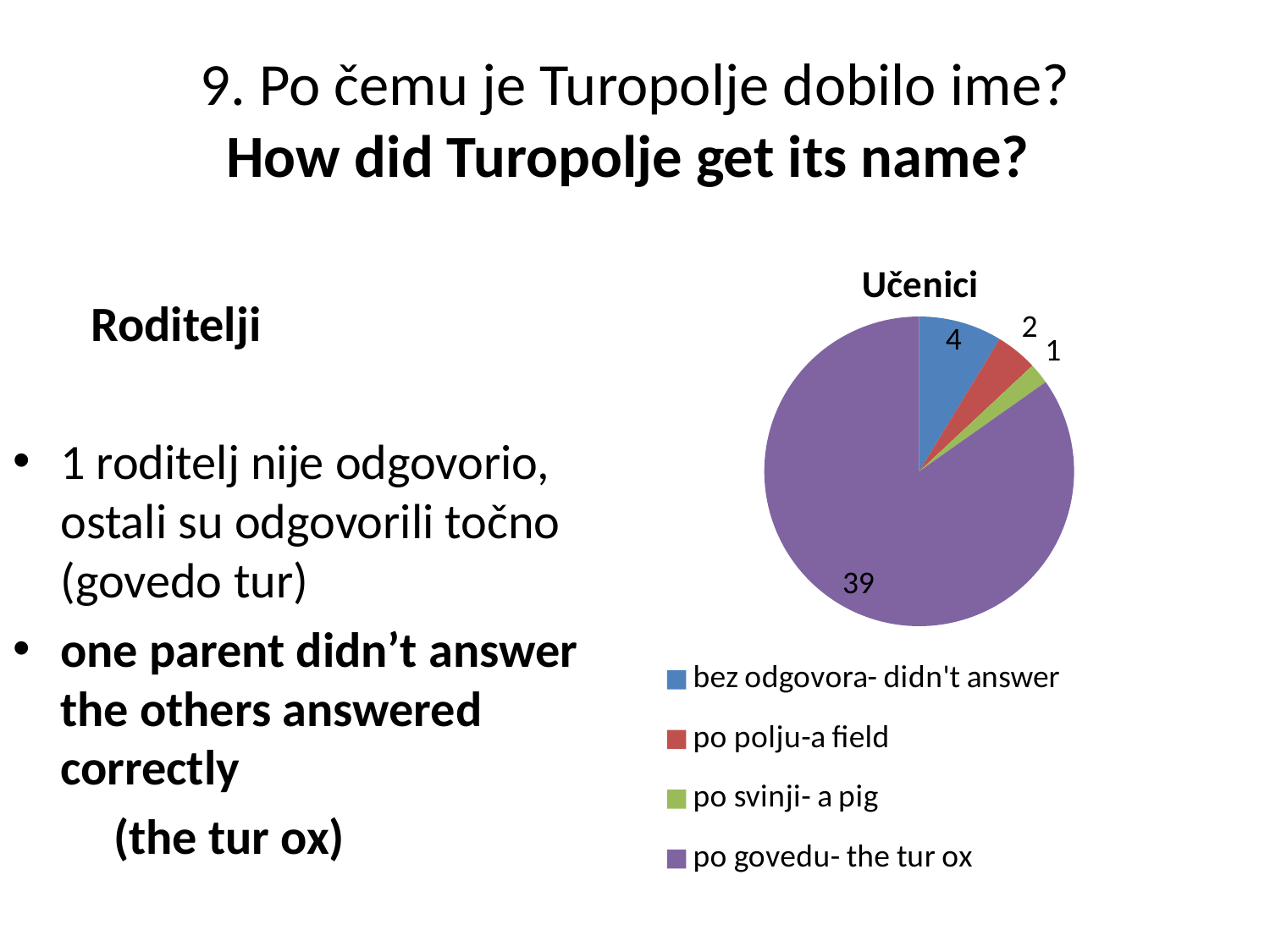
What is the value for 'po polju-a field'? 2 What is the value for 'po svinji- a pig'? 1 What is the value for 'bez odgovora- didn't answer'? 4 What is the difference between the values for 'po govedu- the tur ox' and 'bez odgovora- didn't answer'? 35 What is the total of all slices in the pie chart? 46 What type of chart is shown on the slide? pie chart How many slices does the pie chart have? 4 What is the title of the chart? Učenici Which category has the largest slice? po govedu- the tur ox Which category has the smallest slice? po svinji- a pig What is the value for 'po govedu- the tur ox'? 39 Which is larger, the value for 'po polju-a field' or 'bez odgovora- didn't answer'? bez odgovora- didn't answer